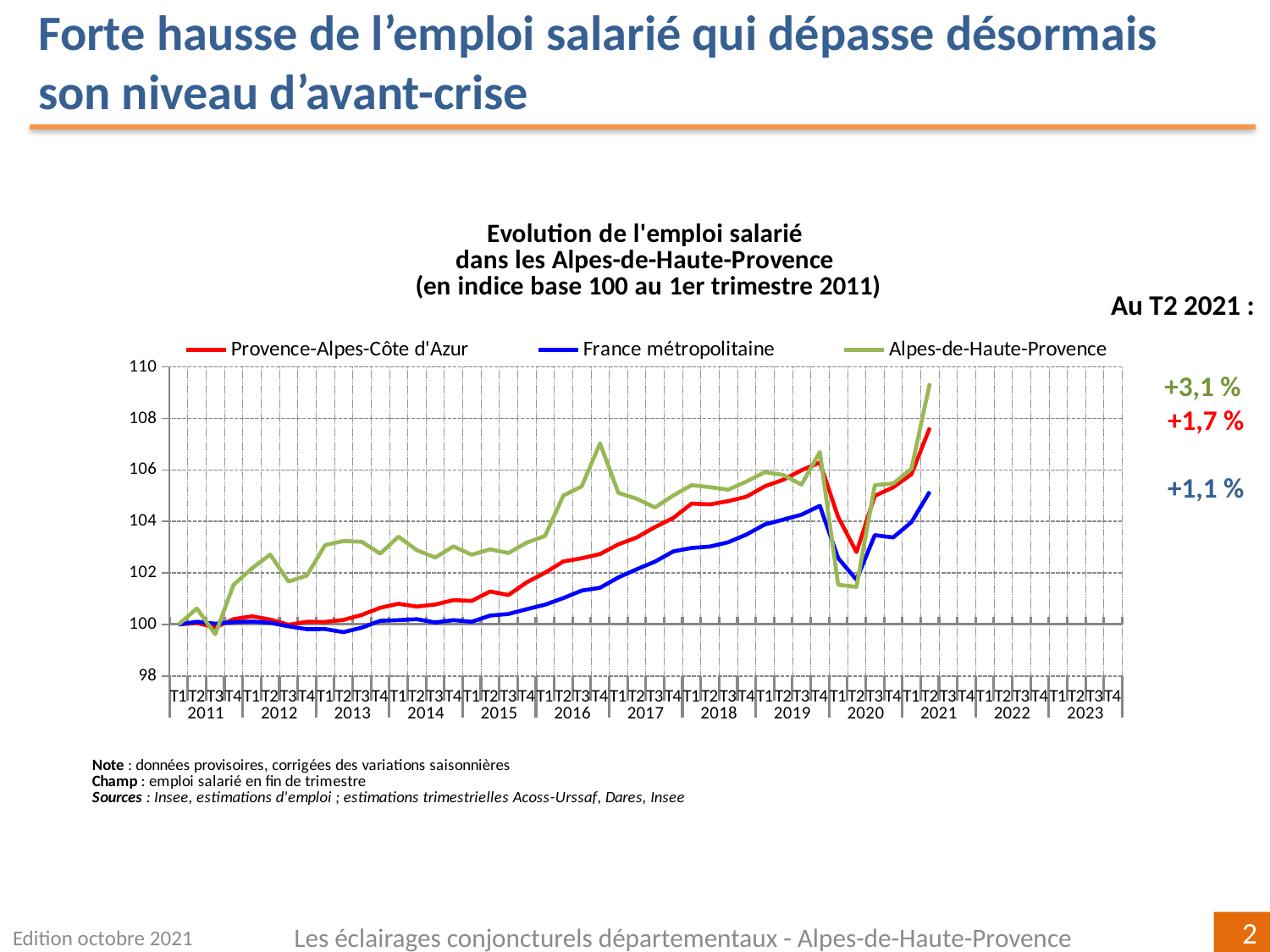
Does the France métropolitaine series rise or fall between T1 2016 and T4 2019? rise Which series has the highest value at T2 2021? Alpes-de-Haute-Provence At T4 2016, which series is higher: Alpes-de-Haute-Provence or Provence-Alpes-Côte d'Azur? Alpes-de-Haute-Provence How many series does the legend of the chart list? 3 What is the index value of all three series at T1 2011? 100 What kind of chart is shown on the slide? line chart Is the value for France métropolitaine at T2 2021 greater or less than 106? less Which series are listed in the chart legend? Provence-Alpes-Côte d'Azur, France métropolitaine, Alpes-de-Haute-Provence Is the value for Alpes-de-Haute-Provence at T2 2020 greater or less than 102? less What growth rate is shown in green for Alpes-de-Haute-Provence under 'Au T2 2021'? +3,1 % Is the value for Alpes-de-Haute-Provence at T2 2021 greater or less than 108? greater Which series has the lowest value at T2 2021? France métropolitaine